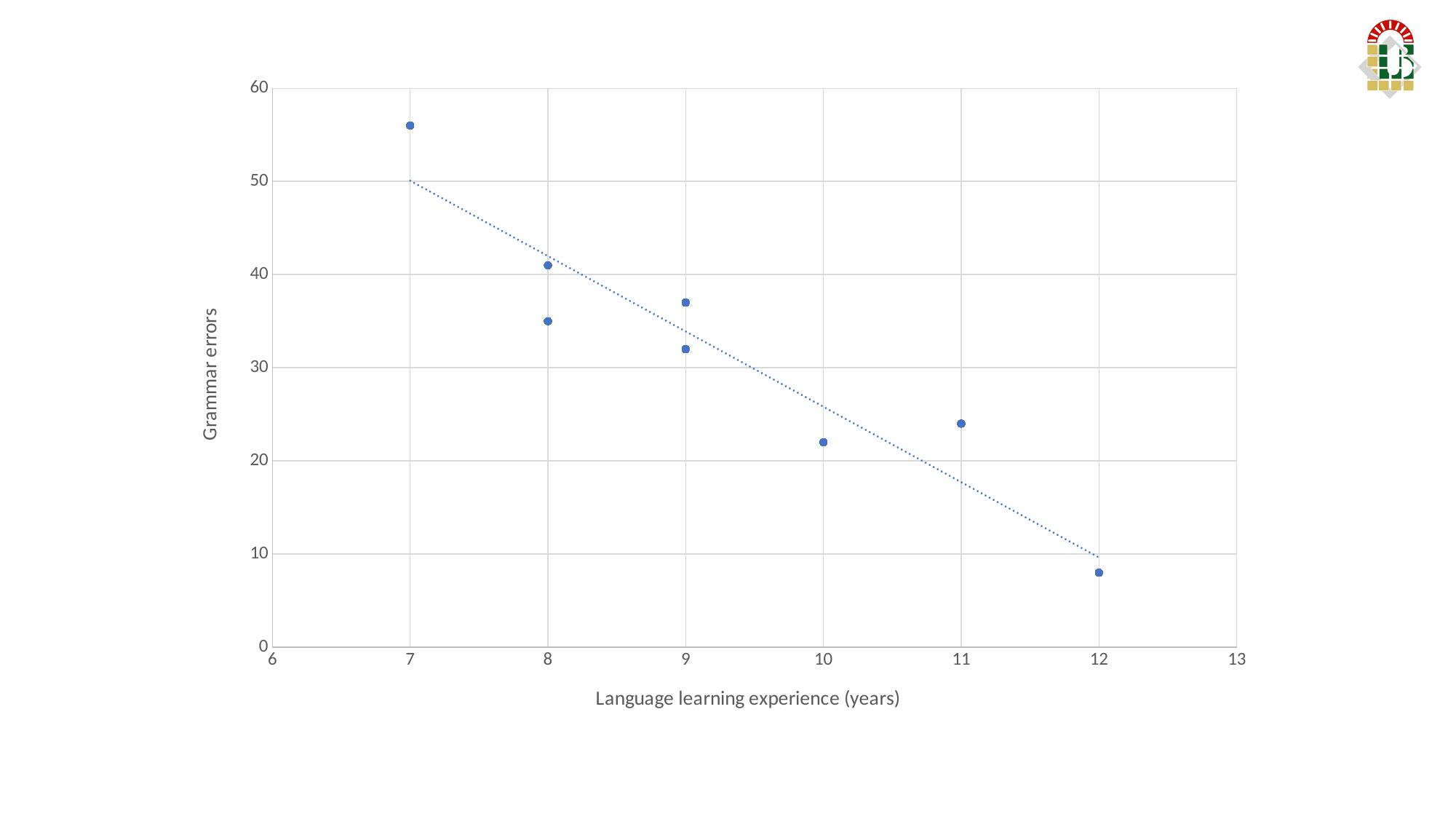
Is the number of grammar errors at 12 years of experience greater or less than 10? less What kind of chart is shown on the slide? Scatter chart Is the number of grammar errors at 11 years of experience greater or less than 20? greater At how many years of language learning experience is the number of grammar errors highest? 7 Is the number of grammar errors at 7 years of experience greater or less than 50? greater Which has more grammar errors: the point at 7 years of experience or the point at 12 years of experience? 7 years What is the title of the horizontal axis? Language learning experience (years) At how many years of language learning experience is the number of grammar errors lowest? 12 How many data points are plotted at 8 years of language learning experience? 2 What is the title of the vertical axis? Grammar errors How many data points are plotted on the chart? 8 Do grammar errors rise or fall as language learning experience increases? Fall